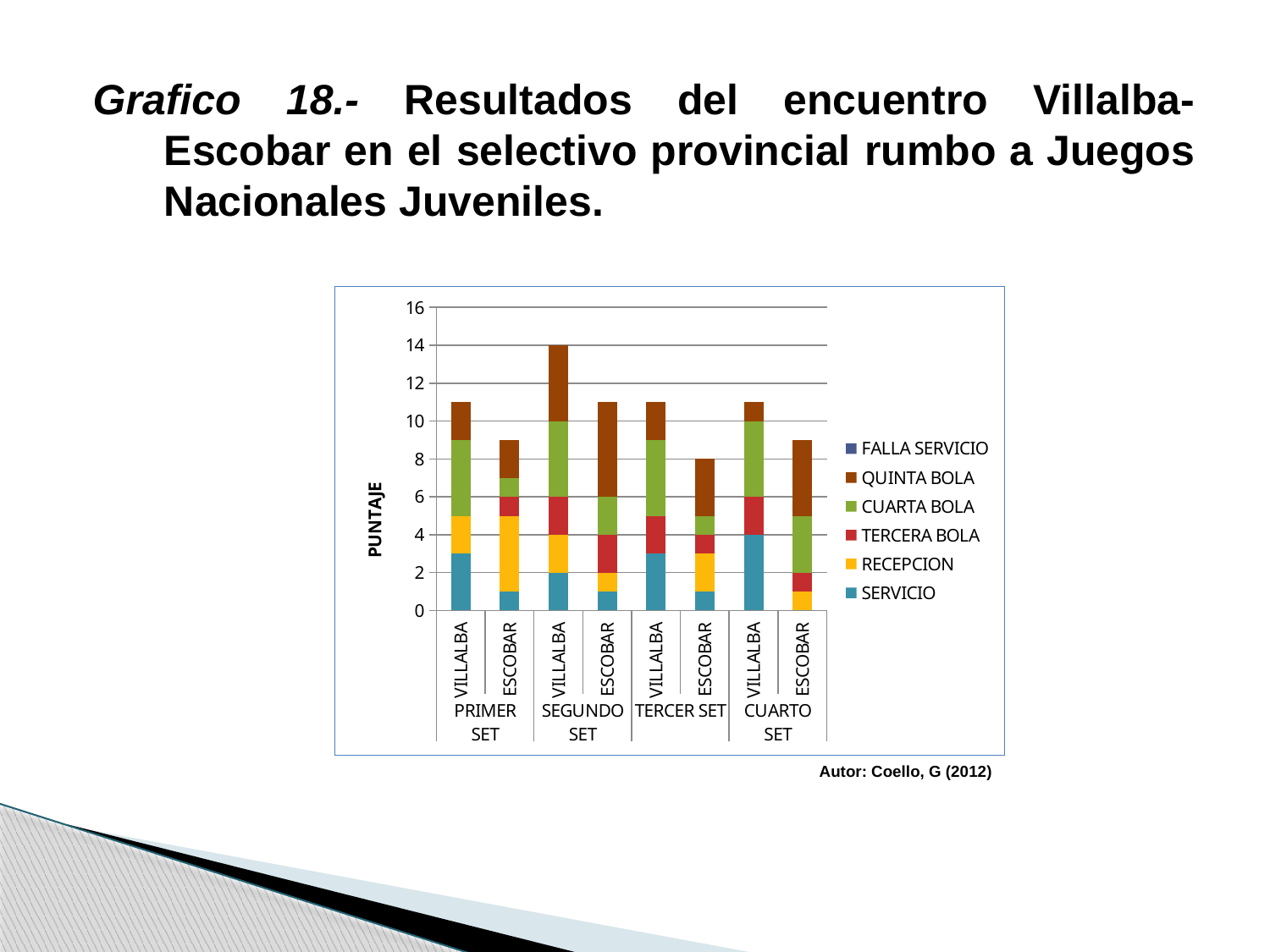
What is the total score of the VILLALBA bar in the SEGUNDO SET? 14 Is the total for VILLALBA in the PRIMER SET greater or less than 10? greater Which bar has the lowest total score? ESCOBAR, TERCER SET In the SEGUNDO SET, which player has the larger total, VILLALBA or ESCOBAR? VILLALBA What is the total score of the ESCOBAR bar in the TERCER SET? 8 Which bar reaches the highest total score? VILLALBA, SEGUNDO SET Which series is listed first (at the top) in the legend? FALLA SERVICIO How many series does the legend list? 6 Is the total for ESCOBAR in the CUARTO SET greater or less than 10? less How many bars are plotted in the chart? 8 What is the title of the vertical axis? PUNTAJE What kind of chart is shown on the slide? Stacked bar chart